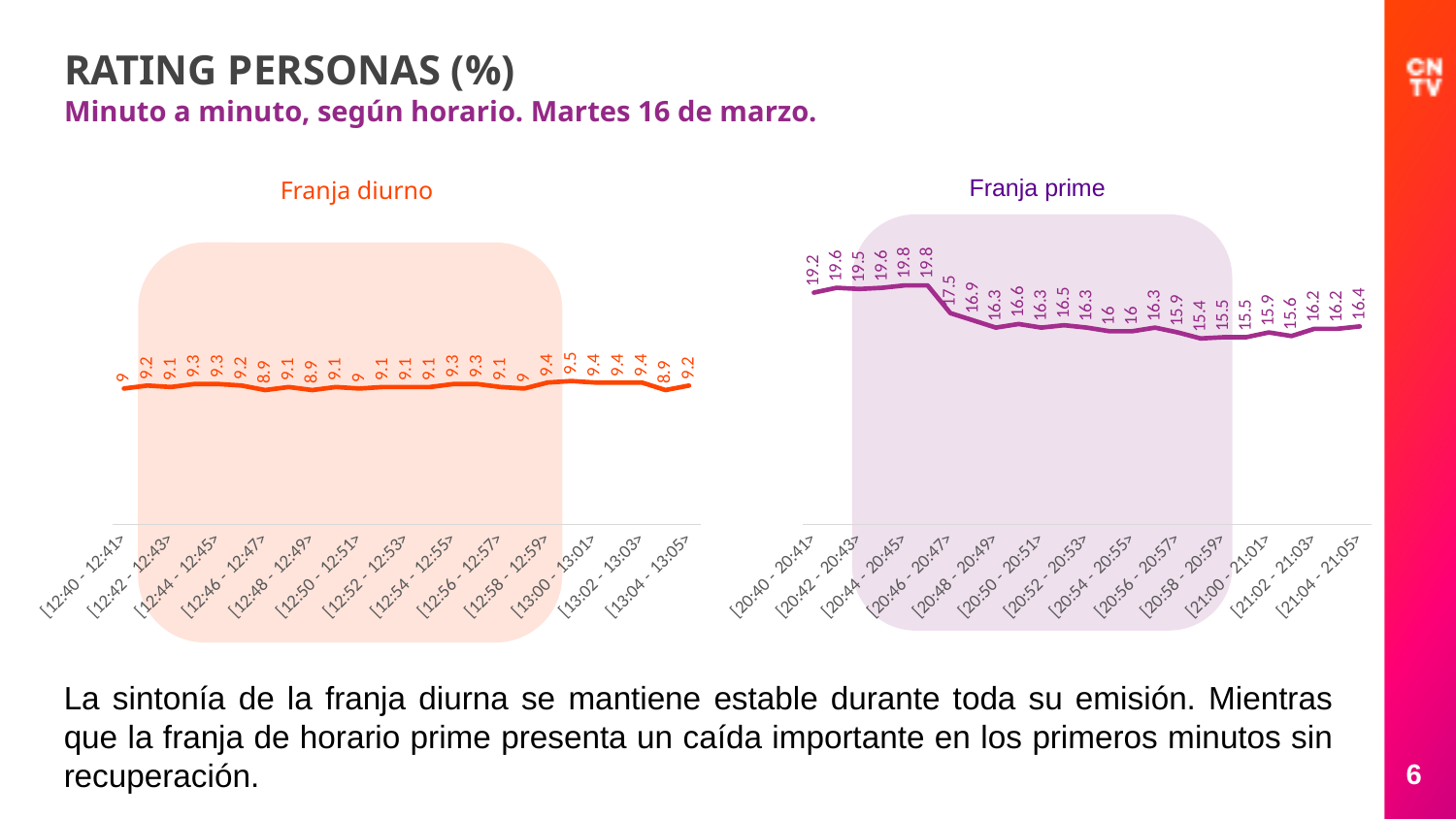
In the Franja diurno chart, what is the value for the last interval, [13:04 - 13:05>? 9.2 In the Franja prime chart, what is the difference between the first value (19.2) and the last value (16.4)? 2.8 Which is larger: the first value of the Franja prime chart or the first value of the Franja diurno chart? Franja prime In the Franja prime chart, what is the lowest value plotted? 15.4 In the Franja prime chart, what is the value for the first interval, [20:40 - 20:41>? 19.2 How many data points are plotted in the Franja prime chart? 25 What kind of chart is the Franja diurno chart? line chart In the Franja diurno chart, what is the highest value plotted? 9.5 In the Franja diurno chart, what is the value for the first interval, [12:40 - 12:41>? 9 In the Franja prime chart, do the values overall rise or fall from the first interval to the last? fall In the Franja prime chart, what is the value for the last interval, [21:04 - 21:05>? 16.4 In the Franja prime chart, what is the highest value plotted? 19.8